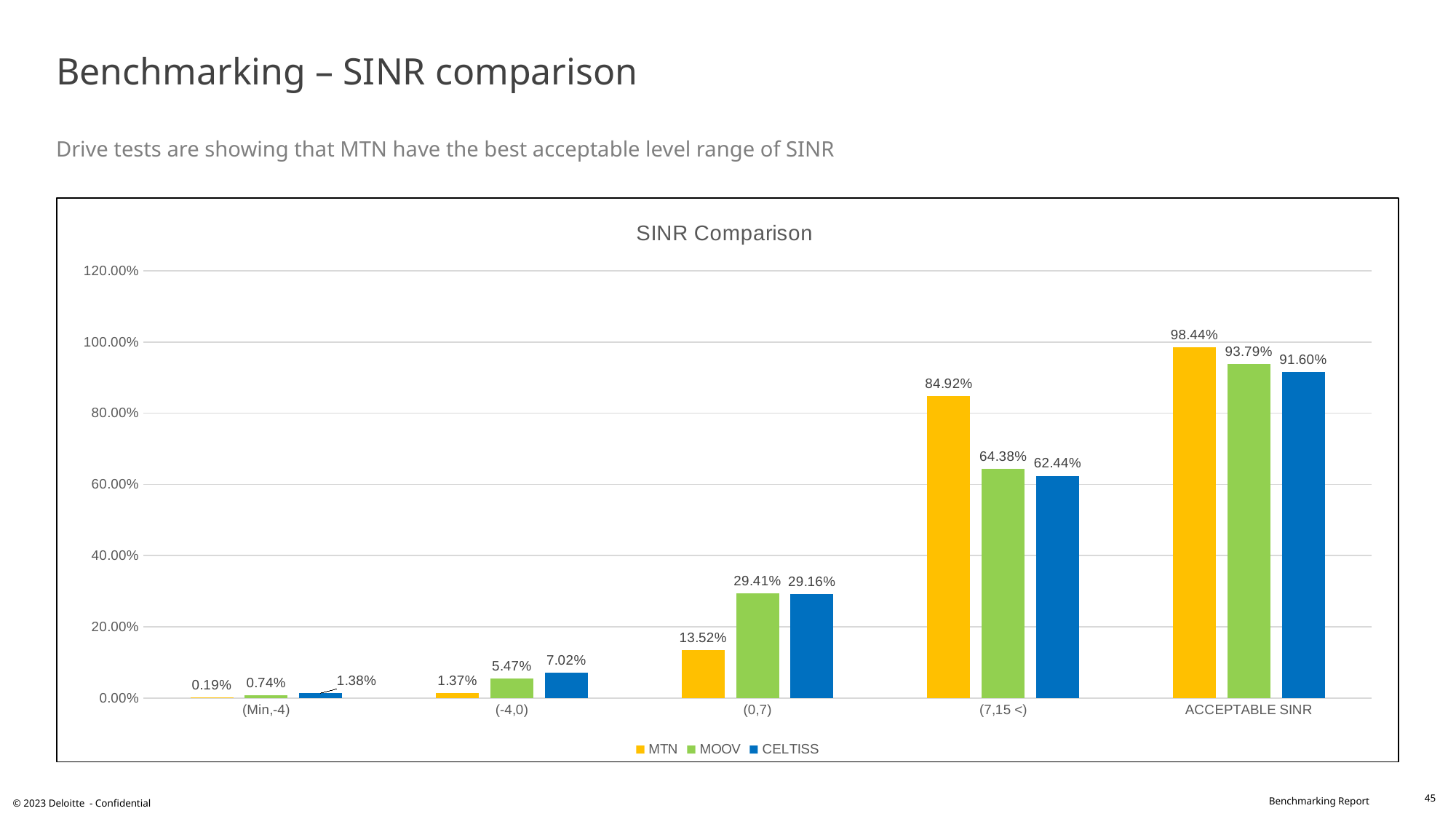
How many series does the legend list? 3 What is the title of the chart? SINR Comparison Which operator has the lowest value in the (-4,0) category? MTN What kind of chart is shown on the slide? Bar chart What is the value for CELTISS in the (7,15 <) category? 62.44% What is the difference between MTN and MOOV in the (7,15 <) category? 20.54% Is the value for MTN in the (7,15 <) category greater or less than 80.00%? greater Which operator has the highest value in the (7,15 <) category? MTN How many categories are shown on the x axis? 5 What is the value for MTN in the ACCEPTABLE SINR category? 98.44% Which is larger in the (-4,0) category: MOOV or CELTISS? CELTISS What is the value for MOOV in the (0,7) category? 29.41%